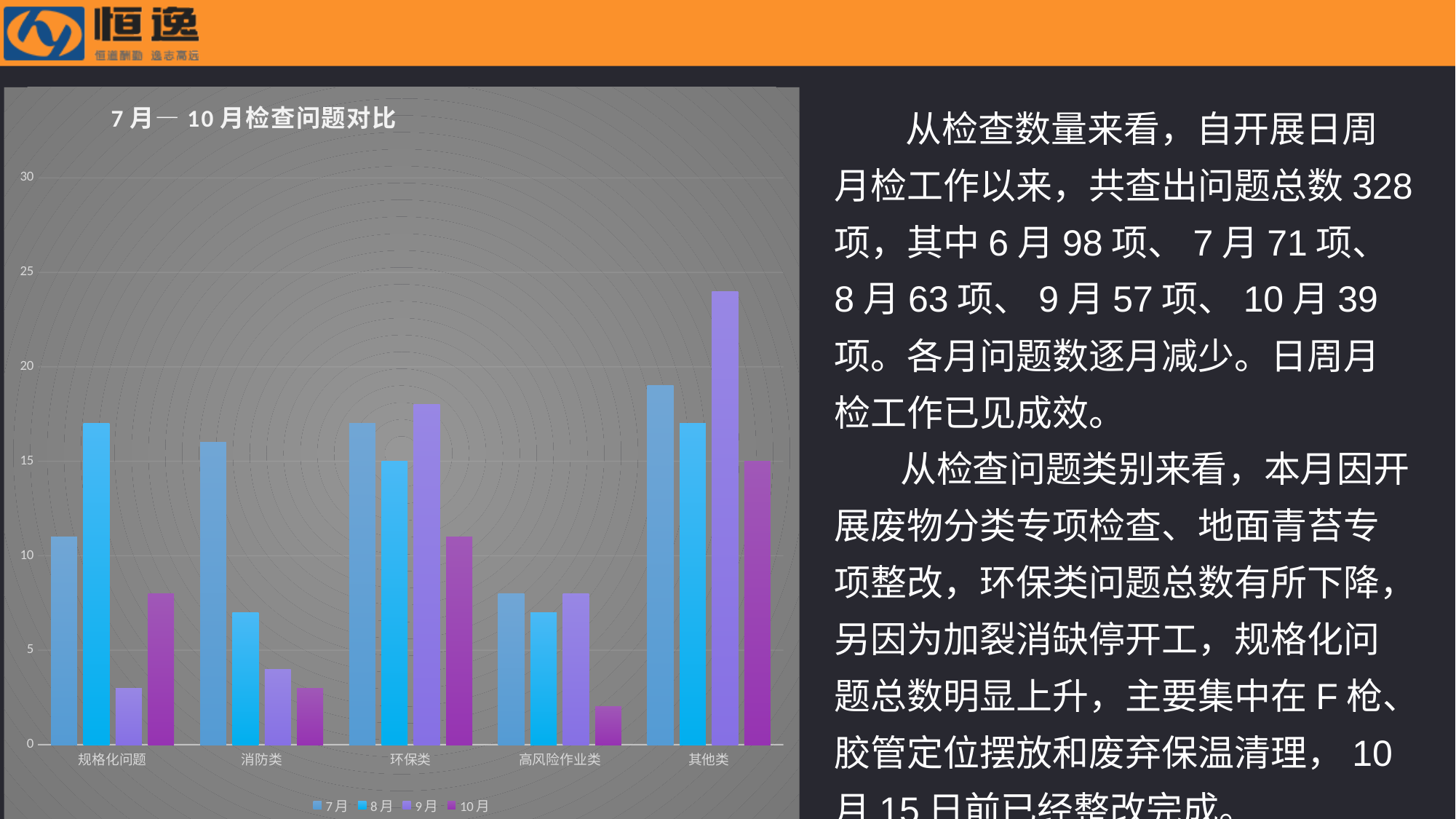
Which category has the shortest 10月 bar? 高风险作业类 How many categories are shown on the x axis of the chart? 5 What is the title of the chart? 7月— 10月检查问题对比 Is the 7月 value for 消防类 greater or less than 10? greater Is the 10月 value for 高风险作业类 greater or less than 5? less How many series does the chart legend list? 4 Is the 9月 value for 其他类 greater or less than 20? greater For 消防类, which is larger, the 7月 value or the 10月 value? 7月 Which category has the tallest 9月 bar? 其他类 For 规格化问题, which is larger, the 7月 value or the 8月 value? 8月 What kind of chart is shown on the slide? bar chart